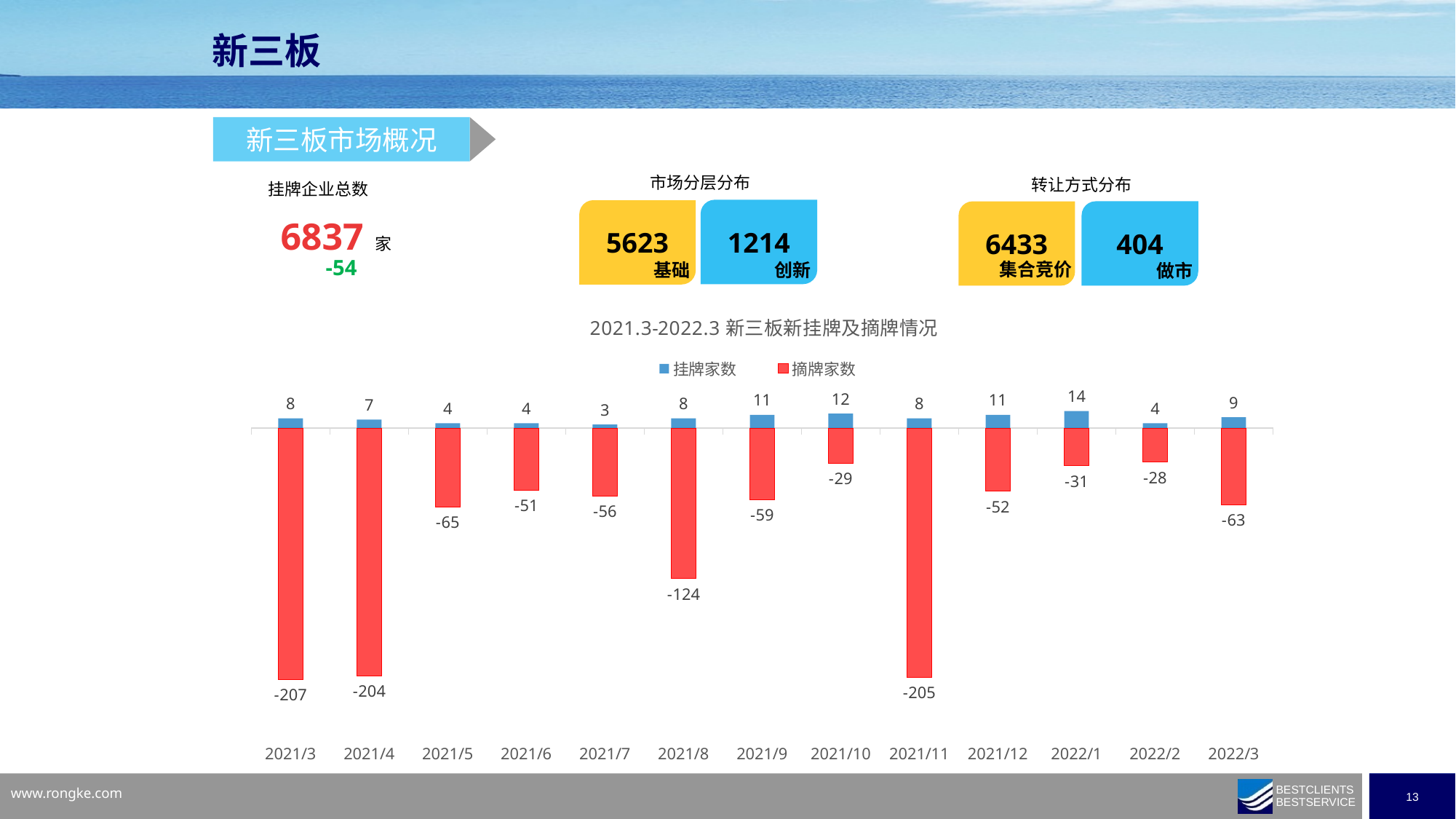
How many months are shown on the x axis of the chart? 13 How many series does the chart legend list? 2 Which month has the highest 挂牌家数? 2022/1 Which month has the 摘牌家数 value closest to zero (smallest magnitude)? 2022/2 Which month has the lowest 挂牌家数? 2021/7 What is the 挂牌家数 value for 2021/10? 12 What type of chart is used to show 新挂牌及摘牌情况? Bar chart What is the 摘牌家数 value for 2021/8? -124 What is the title of the chart? 2021.3-2022.3 新三板新挂牌及摘牌情况 What is the 摘牌家数 value for 2022/3? -63 Which is larger in magnitude, the 摘牌家数 for 2021/3 or 2021/11? 2021/3 What is the difference between the 挂牌家数 for 2022/1 and 2022/2? 10